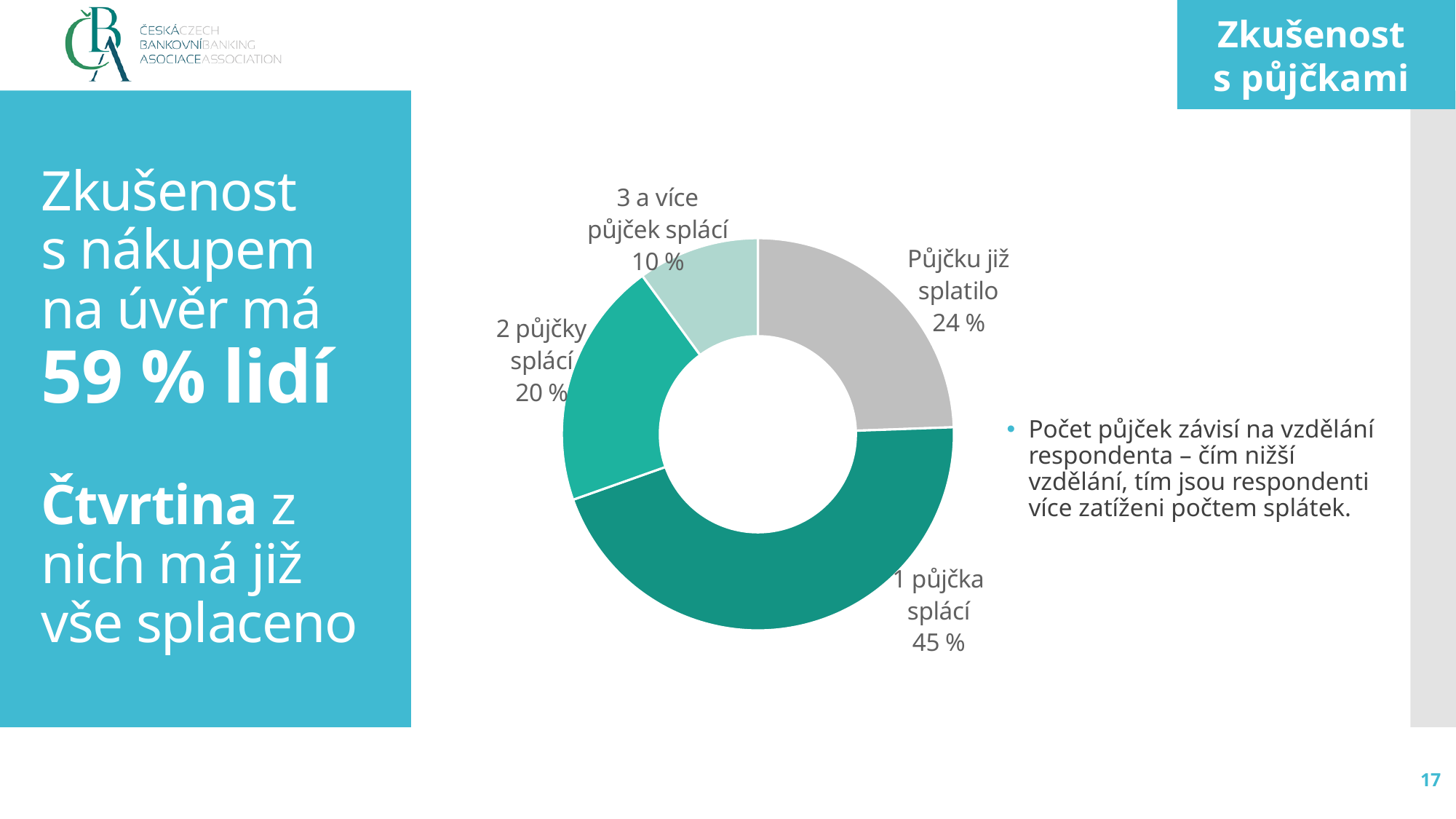
What kind of chart is shown on the slide? Doughnut (pie) chart Which is larger: the share for "2 půjčky splácí" or the share for "3 a více půjček splácí"? 2 půjčky splácí What share of respondents is shown for "3 a více půjček splácí"? 10 % What is the difference in percentage points between "1 půjčka splácí" and "Půjčku již splatilo"? 21 percentage points Which category has the smallest share in the chart? 3 a více půjček splácí What is the combined share of respondents who are still repaying two or more loans ("2 půjčky splácí" and "3 a více půjček splácí")? 30 % What share of respondents is shown for "Půjčku již splatilo"? 24 % What share of respondents is shown for "1 půjčka splácí"? 45 % What share of respondents is shown for "2 půjčky splácí"? 20 % How many categories does the chart show? 4 Which category has the largest share in the chart? 1 půjčka splácí What colour is the slice for "Půjčku již splatilo"? Grey